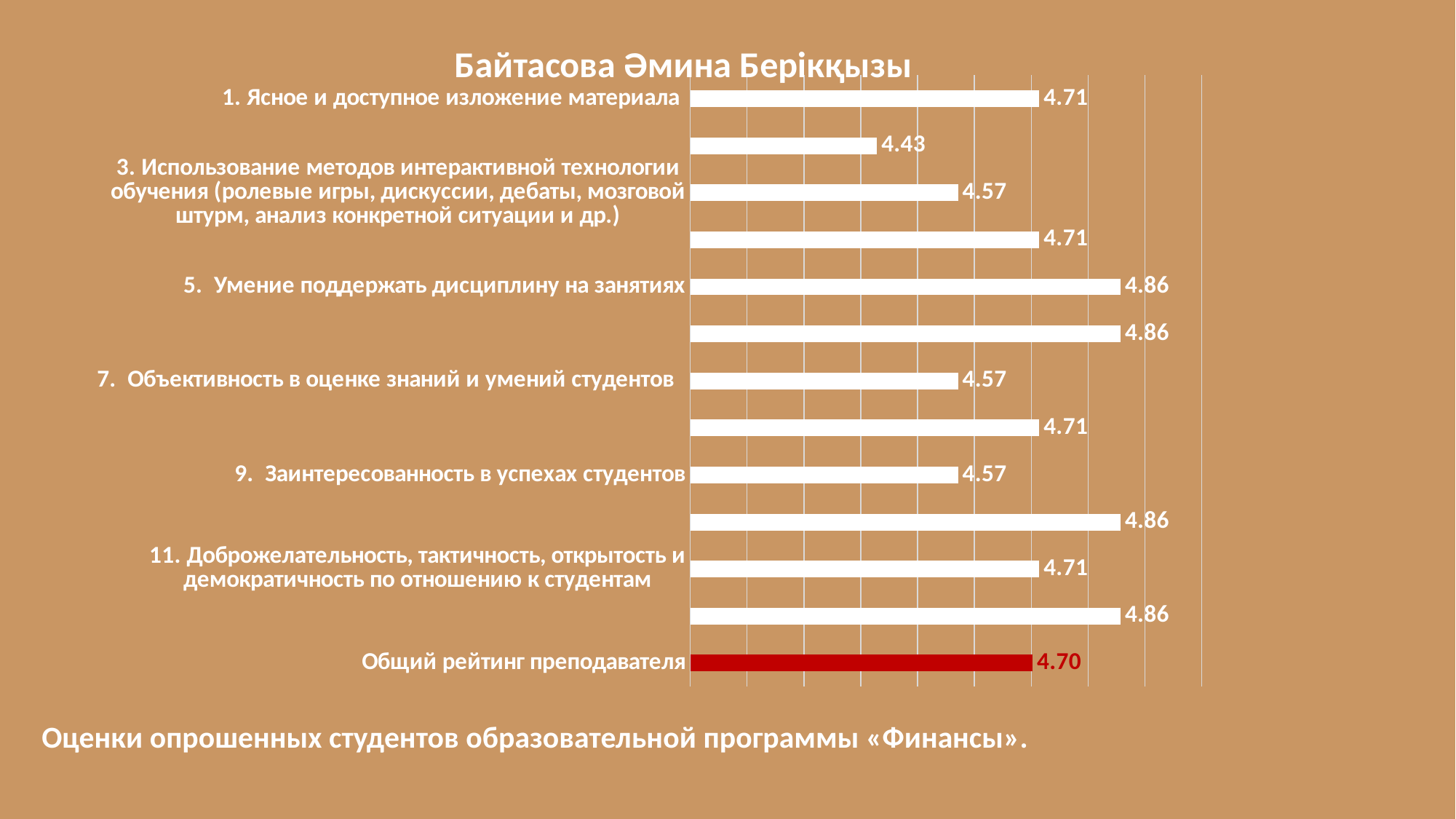
What kind of chart is shown on the slide? Bar chart What is the title of the chart? Байтасова Әмина Берікқызы What is the difference between the value for '5. Умение поддержать дисциплину на занятиях' and the value for '7. Объективность в оценке знаний и умений студентов'? 0.29 What is the value for 'Общий рейтинг преподавателя'? 4.70 What is the value for '5. Умение поддержать дисциплину на занятиях'? 4.86 Which is larger: the value for '5. Умение поддержать дисциплину на занятиях' or the value for '9. Заинтересованность в успехах студентов'? 5. Умение поддержать дисциплину на занятиях What is the value for '11. Доброжелательность, тактичность, открытость и демократичность по отношению к студентам'? 4.71 How many bars are plotted on the chart? 13 What is the lowest value shown on the chart? 4.43 What is the value for '7. Объективность в оценке знаний и умений студентов'? 4.57 What is the value for '9. Заинтересованность в успехах студентов'? 4.57 What is the value for '1. Ясное и доступное изложение материала'? 4.71